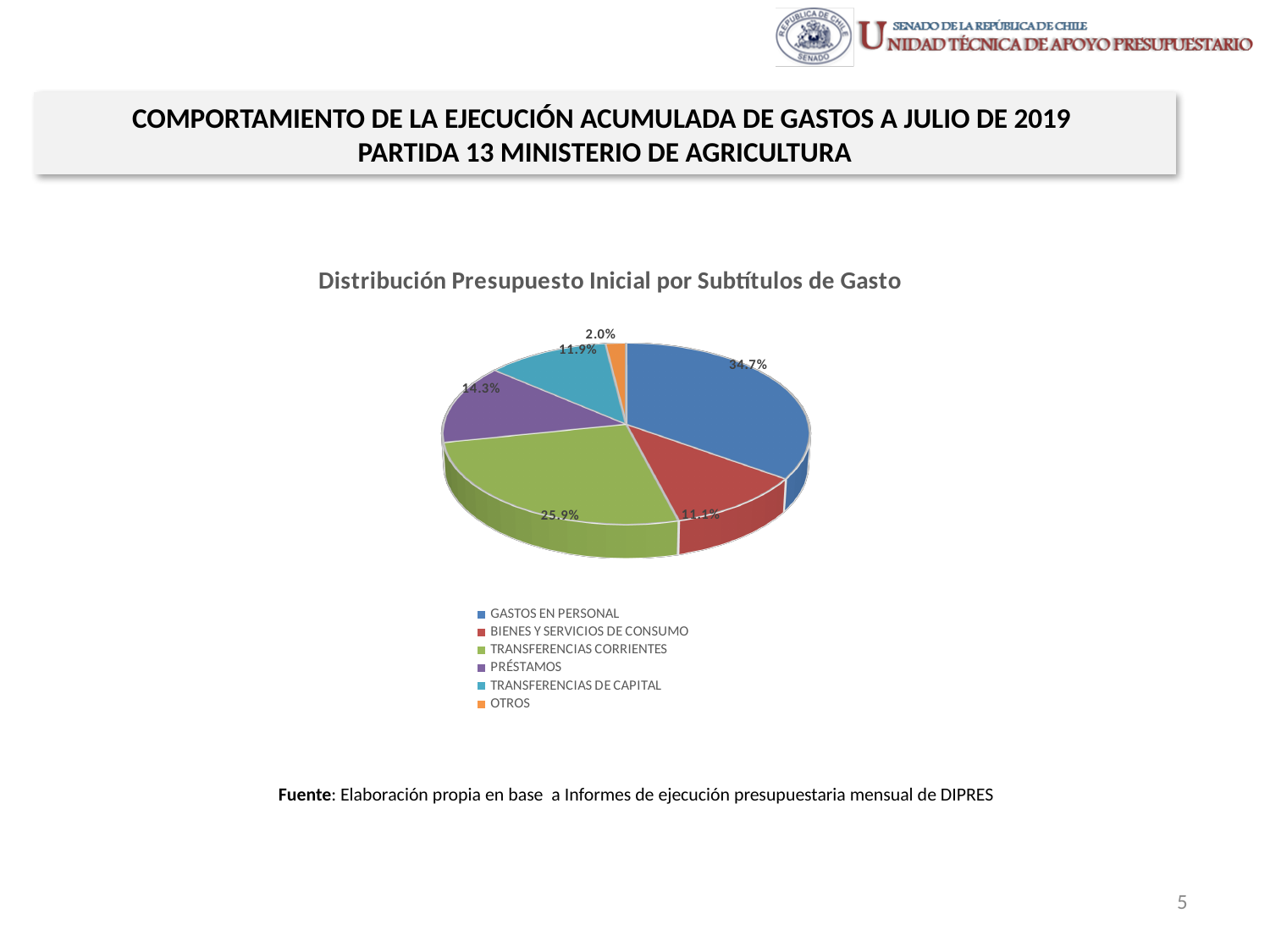
What is the title of the chart? Distribución Presupuesto Inicial por Subtítulos de Gasto What share of the pie does PRÉSTAMOS represent? 14.3% What is the difference in percentage points between GASTOS EN PERSONAL and TRANSFERENCIAS CORRIENTES? 8.8 What share of the pie does BIENES Y SERVICIOS DE CONSUMO represent? 11.1% Which category has the smallest slice of the pie? OTROS How many categories does the legend list? 6 What share of the pie does TRANSFERENCIAS CORRIENTES represent? 25.9% Which is larger, the share for PRÉSTAMOS or the share for TRANSFERENCIAS DE CAPITAL? PRÉSTAMOS Which category has the largest slice of the pie? GASTOS EN PERSONAL What kind of chart is shown on the slide? pie chart